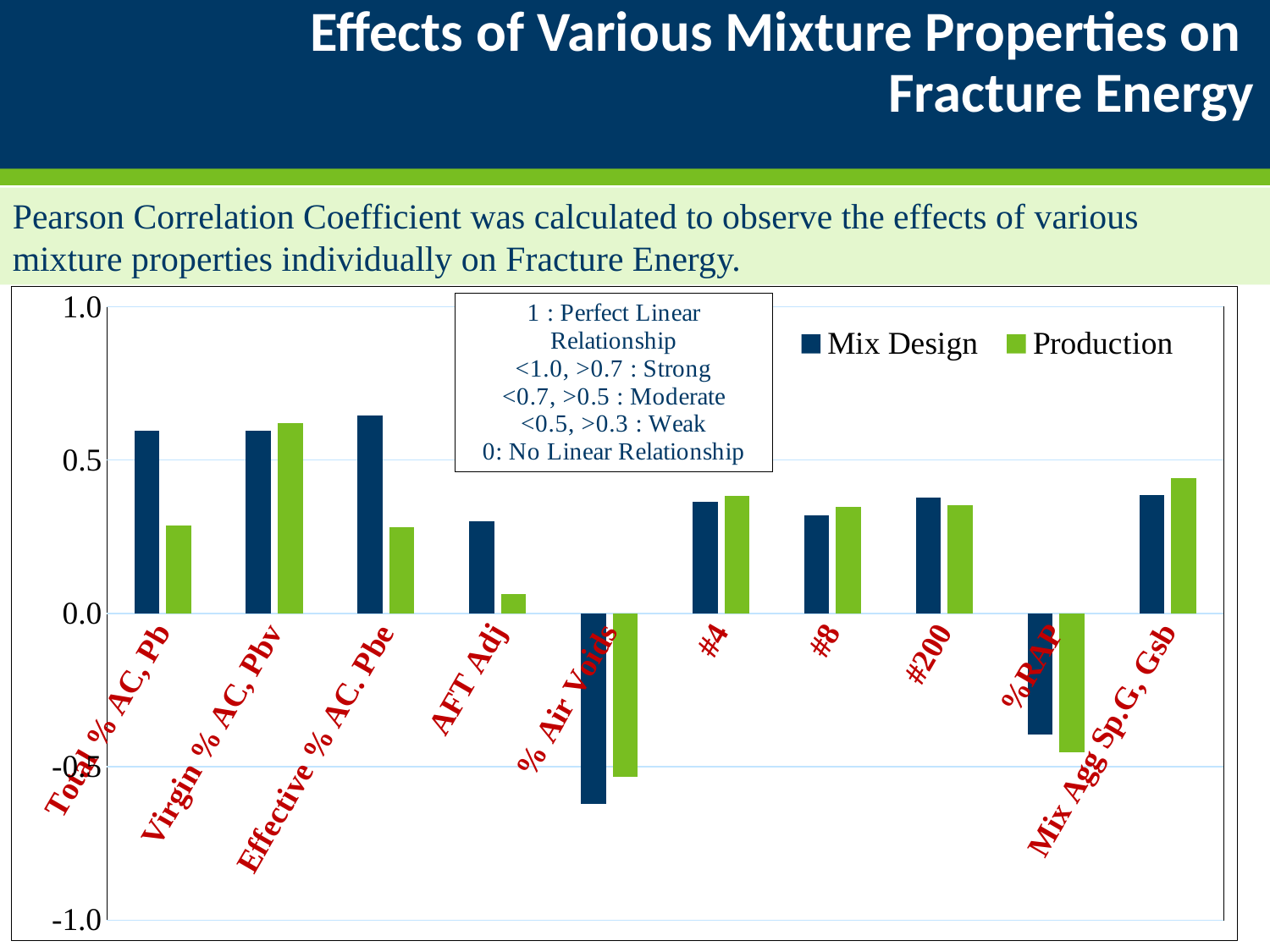
Is the Mix Design value for %RAP greater or less than -0.5? greater Is the Mix Design value for % Air Voids greater or less than -0.5? less Which category has the lowest Mix Design value? % Air Voids Is the Mix Design value for Total % AC, Pb greater or less than 0.5? greater For AFT Adj, which series has the larger value, Mix Design or Production? Mix Design For Effective % AC. Pbe, which series has the larger value, Mix Design or Production? Mix Design Which category has the highest Production value? Virgin % AC, Pbv What kind of chart is shown on the slide? bar chart How many mixture property categories are plotted on the x axis? 10 How many series does the chart legend list? 2 Which series is shown in green in the chart legend? Production